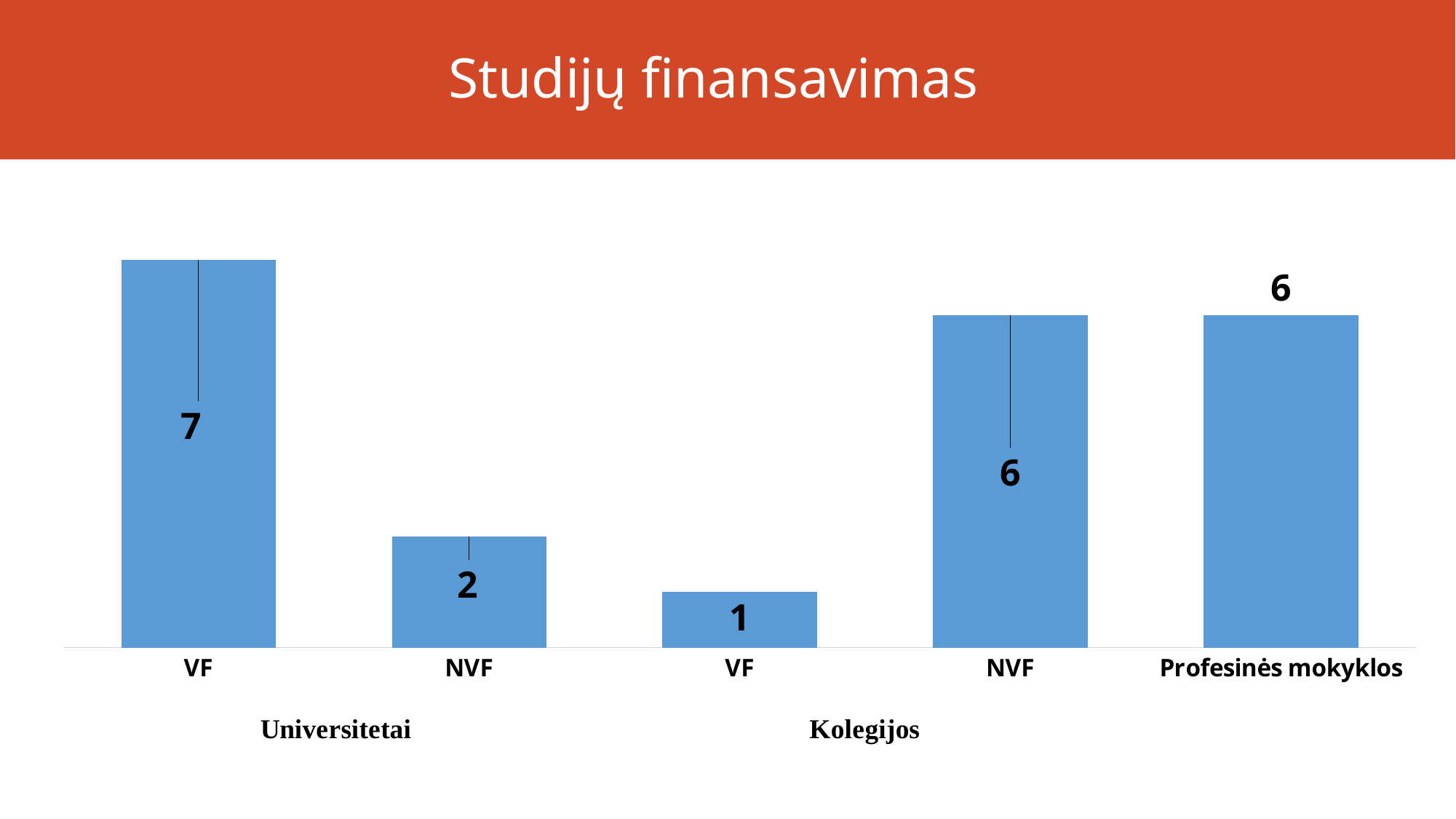
Which is larger: the NVF value for Universitetai or the NVF value for Kolegijos? NVF for Kolegijos Which bar has the lowest value? VF (Kolegijos) Which bar has the highest value? VF (Universitetai) What is the value for VF under Kolegijos? 1 What is the difference between the VF value for Universitetai and the VF value for Kolegijos? 6 What is the value for VF under Universitetai? 7 What type of chart is shown on the slide? Bar chart What is the value for NVF under Universitetai? 2 What is the value for Profesinės mokyklos? 6 What is the value for NVF under Kolegijos? 6 What is the difference between the NVF value for Kolegijos and the NVF value for Universitetai? 4 How many bars are shown in the chart? 5